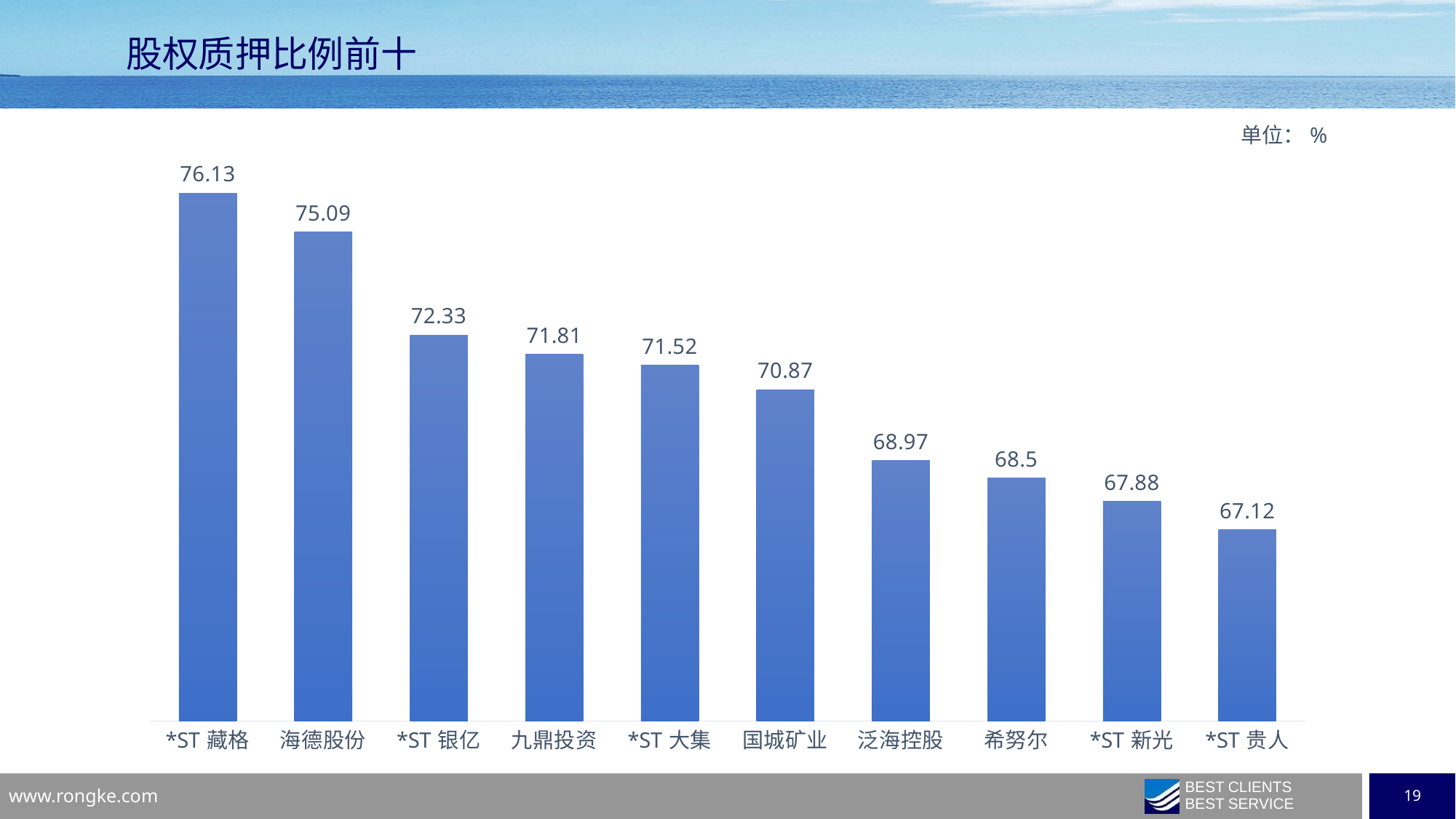
Which category has the lowest value? *ST 贵人 What is the difference between the values for *ST 银亿 and *ST 贵人? 5.21 Which is larger, the value for 九鼎投资 or the value for 泛海控股? 九鼎投资 What is the title of the chart? 股权质押比例前十 What is the value for 希努尔? 68.5 What is the difference between the values for *ST 藏格 and 海德股份? 1.04 Which category has the highest value? *ST 藏格 What is the value for 国城矿业? 70.87 What kind of chart is shown on the slide? bar chart How many categories are shown in the chart? 10 Do the values rise or fall from left to right along the x axis? fall What is the value for *ST 藏格? 76.13